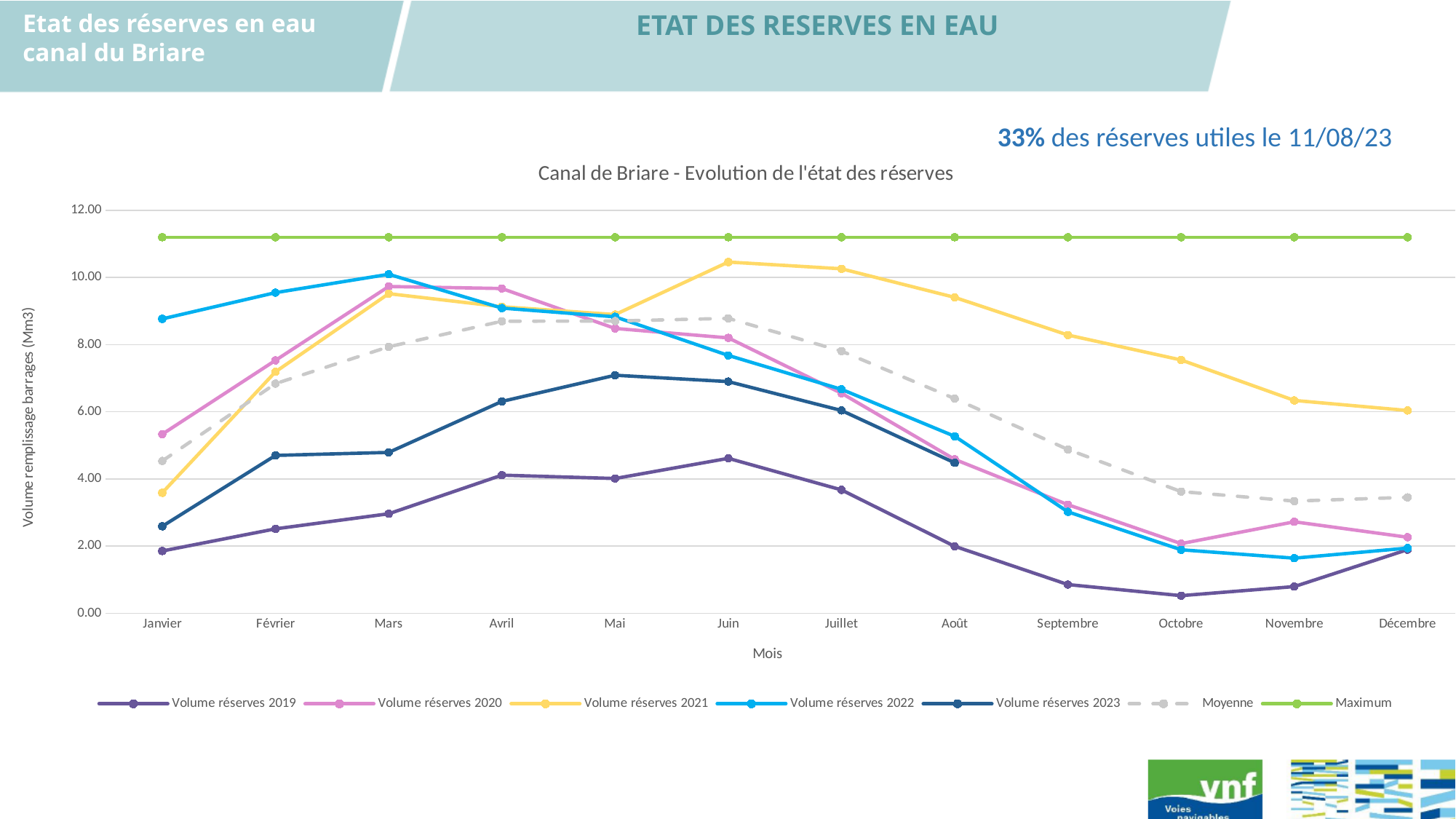
Which series is drawn as a dashed grey line? Moyenne Does the Volume réserves 2021 line rise or fall from Juin to Décembre? fall Is the value for Volume réserves 2022 in Janvier greater or less than 8.00? greater Which of the volume series (2019 to 2023) has the lowest value in Janvier? Volume réserves 2019 How many months are shown along the x axis? 12 Which of the volume series (2019 to 2023) has the highest value in Janvier? Volume réserves 2022 Is the value for Volume réserves 2019 in Octobre greater or less than 2.00? less How many series does the legend list? 7 In Juin, which is larger: Volume réserves 2021 or Volume réserves 2022? Volume réserves 2021 What is the title of the chart? Canal de Briare - Evolution de l'état des réserves Is the value for Volume réserves 2021 in Juin greater or less than 10.00? greater What kind of chart is shown on the slide? line chart